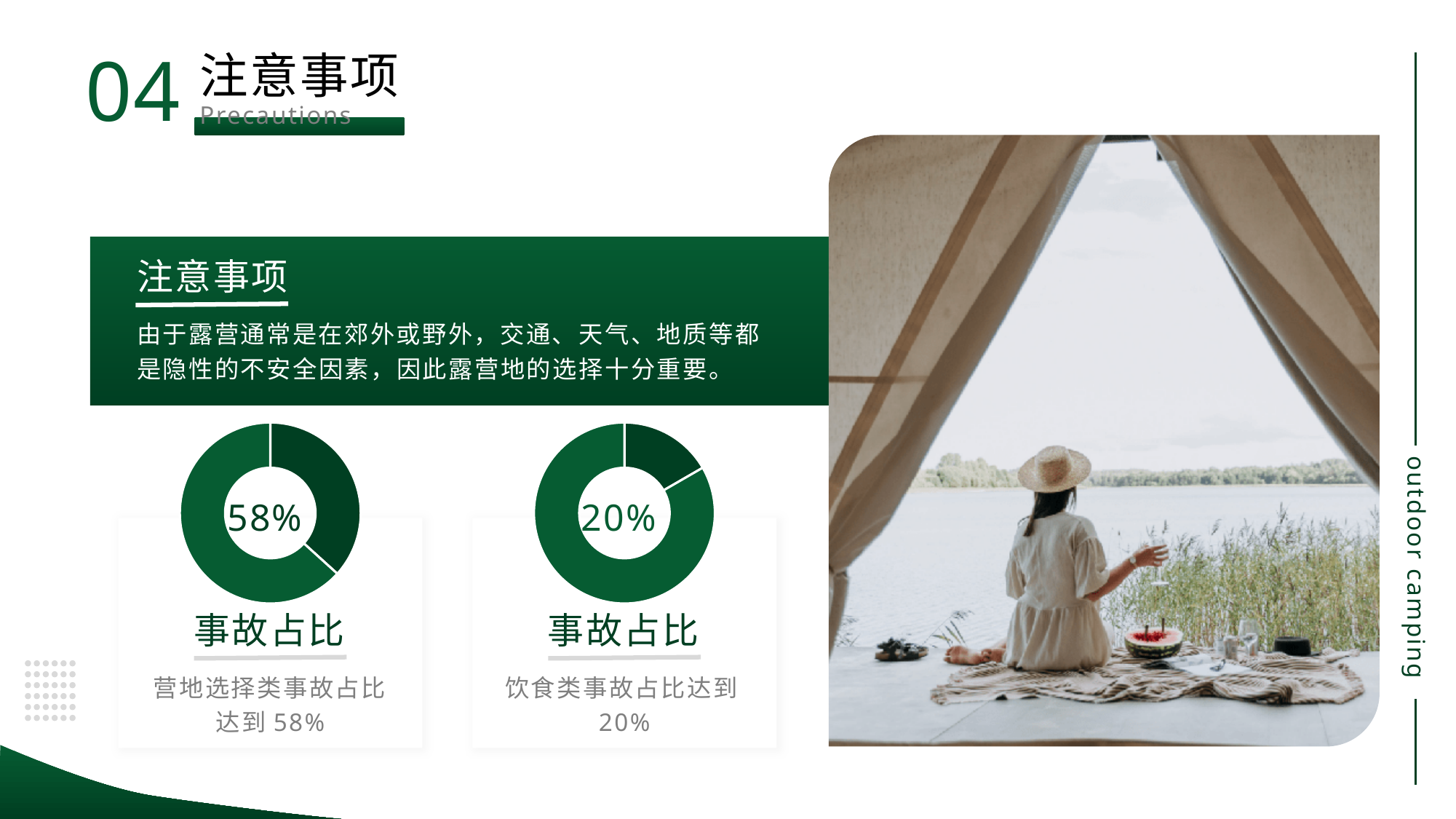
What percentage is shown in the centre of the left donut chart? 58% What percentage is shown in the centre of the right donut chart? 20% How many donut charts are on the slide? 2 What colour are the highlighted segments of the donut charts? Green According to the right donut chart, what share of accidents is attributed to food and drink (饮食类事故)? 20% Is the value shown in the left donut chart greater or less than 50%? greater What kind of chart is used to show the accident proportions on this slide? Donut (pie) chart Which donut chart shows the larger percentage, the left one or the right one? The left one (58%) What is the difference between the percentage in the left donut chart and the percentage in the right donut chart? 38 percentage points According to the left donut chart, what share of accidents is attributed to campsite selection (营地选择类事故)? 58% What label appears directly below each donut chart? 事故占比 Is the value shown in the right donut chart greater or less than 50%? less